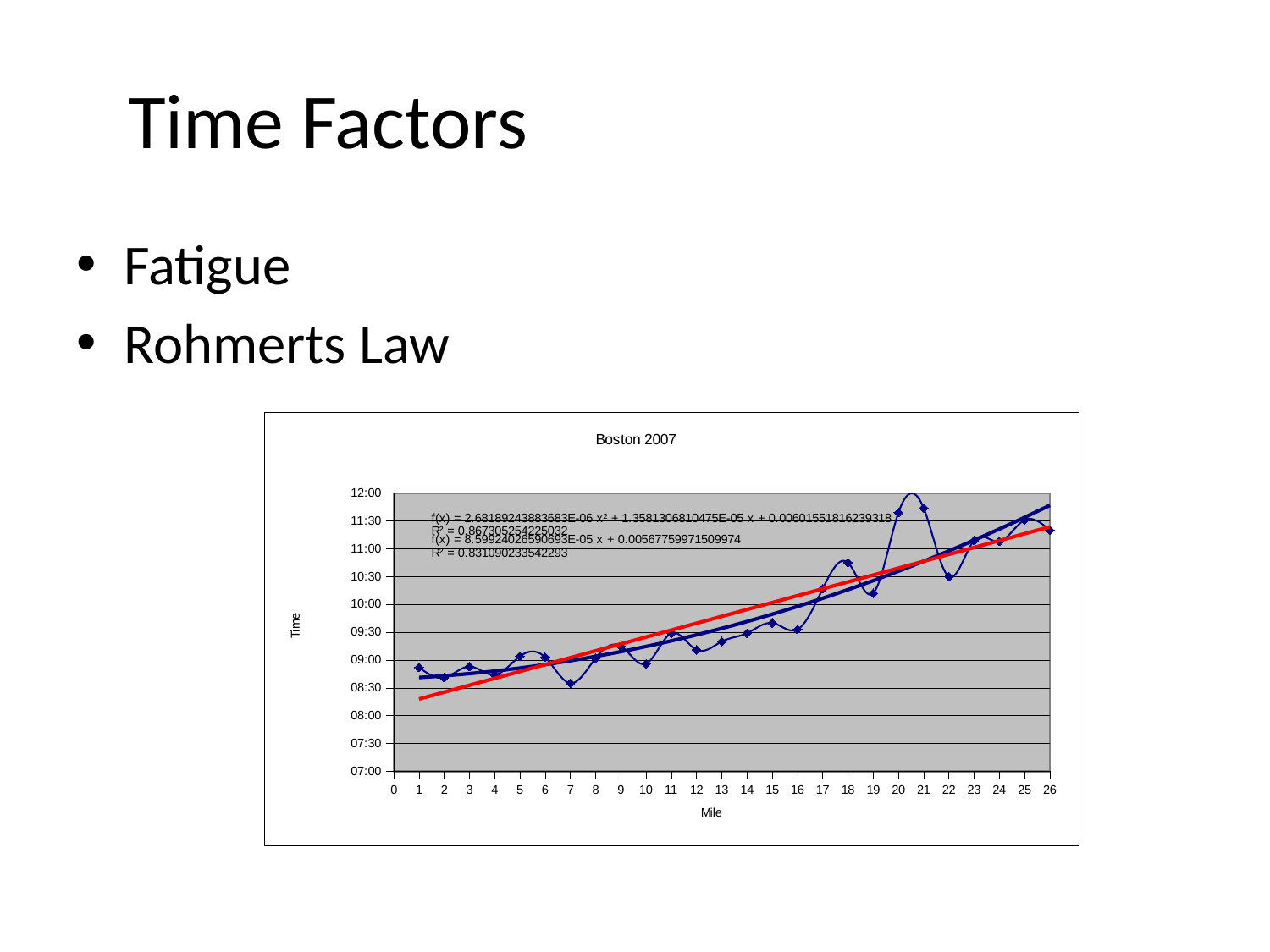
Is the value for mile 26 greater or less than 11:00? greater Is the value for mile 12 greater or less than 09:00? greater Is the value for mile 18 greater or less than 10:30? greater Which mile has the lowest plotted time? 7 Which has the higher plotted time, mile 18 or mile 19? mile 18 Do the plotted times generally rise or fall as the mile number increases? rise Which has the higher plotted time, mile 7 or mile 8? mile 8 What kind of chart is shown on the slide? line chart What is the title of the chart? Boston 2007 How many data points are plotted in the chart? 26 What is the label of the x axis of the chart? Mile